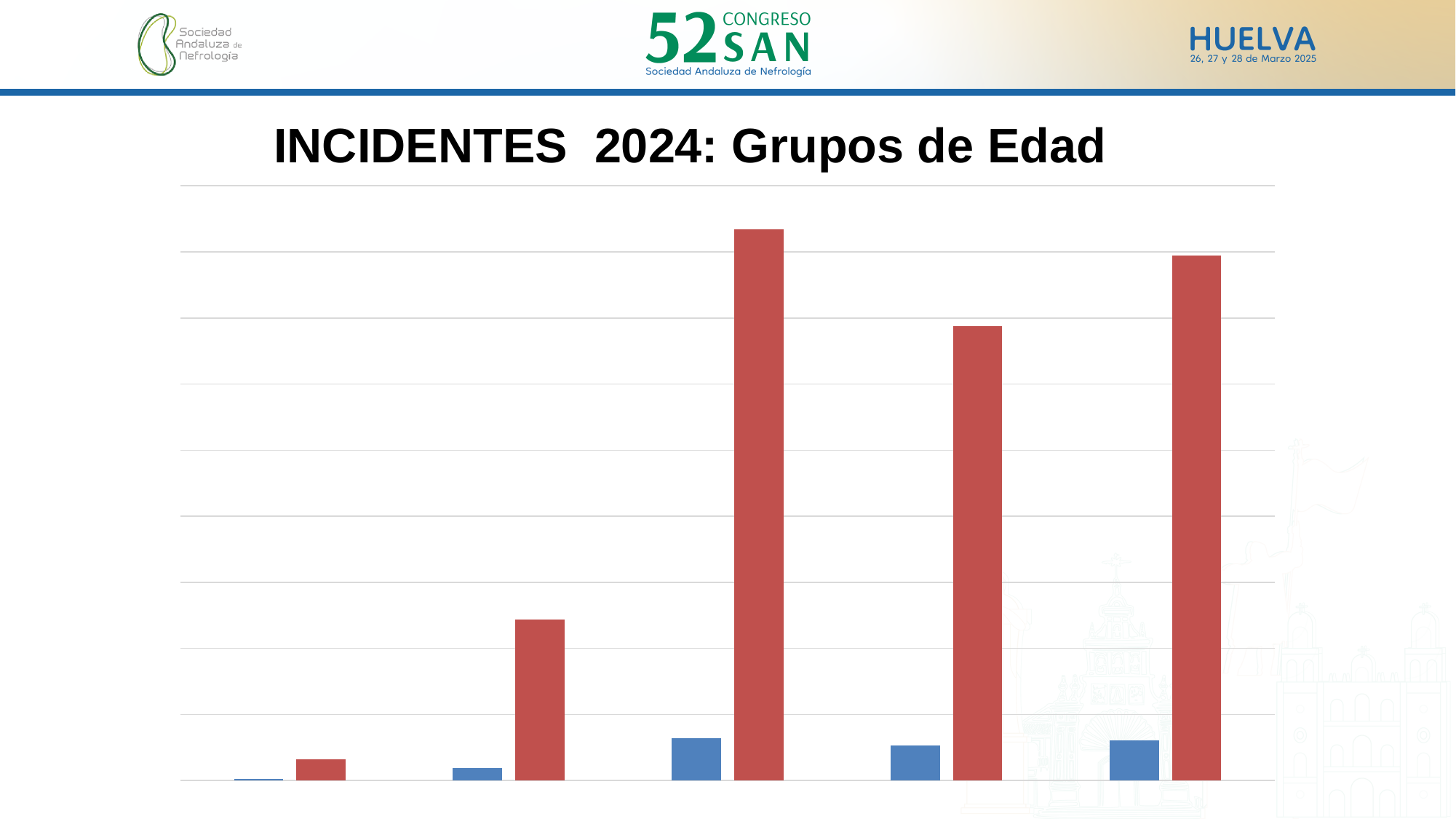
Is the red bar in the third group from the left taller or shorter than the red bar in the fourth group? taller What two colours are used for the bars in the chart? blue and red How many groups of bars are plotted in the chart? 5 How many differently coloured bar series are plotted in the chart? 2 What kind of chart is shown on the slide? bar chart Which group of bars, counting from the left, has the tallest red bar? the third group Is the red bar in the second group from the left taller or shorter than the red bar in the fifth group? shorter In every group, which bar is taller, the blue one or the red one? the red one What is the title of the chart on the slide? INCIDENTES 2024: Grupos de Edad Which group of bars, counting from the left, has the shortest red bar? the first group